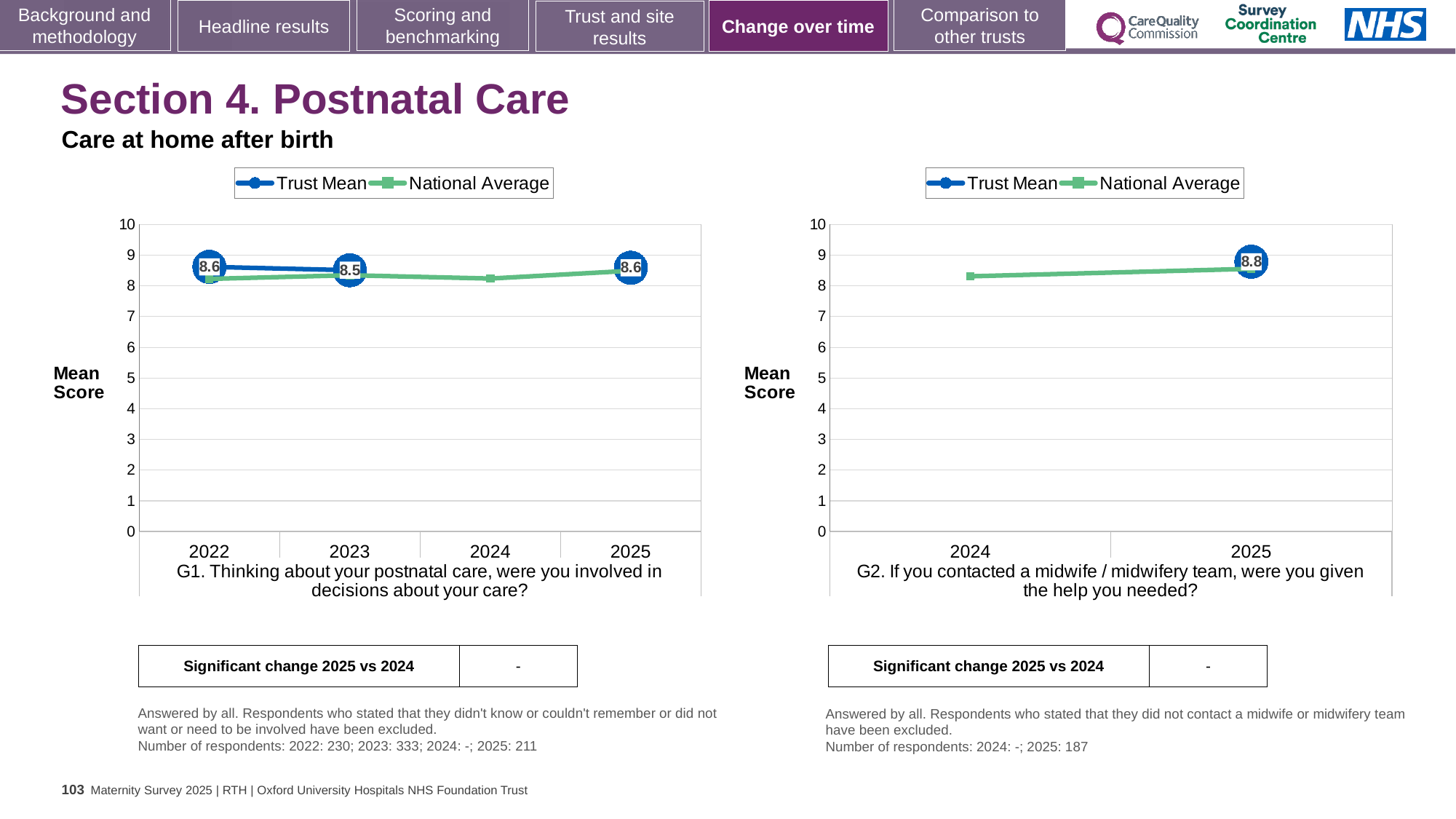
How many years are shown on the x axis of the G1 chart (left)? 4 In the G2 chart (right), what is the Trust Mean for 2025? 8.8 In the G1 chart (left), what is the Trust Mean for 2025? 8.6 In the G1 chart (left), what is the Trust Mean for 2023? 8.5 In the G1 chart (left), which year has the lower Trust Mean, 2022 or 2023? 2023 In the G2 chart (right), is the National Average for 2024 greater or less than 9? less In the G1 chart (left), what is the Trust Mean for 2022? 8.6 What kind of chart is the G2 chart (right)? Line chart What is the label on the y axis of the G1 chart (left)? Mean Score In the G1 chart (left), is the National Average for 2024 greater or less than 9? less How many series does the legend of the G2 chart (right) list? 2 In the G1 chart (left), what is the difference between the Trust Mean for 2022 and for 2023? 0.1